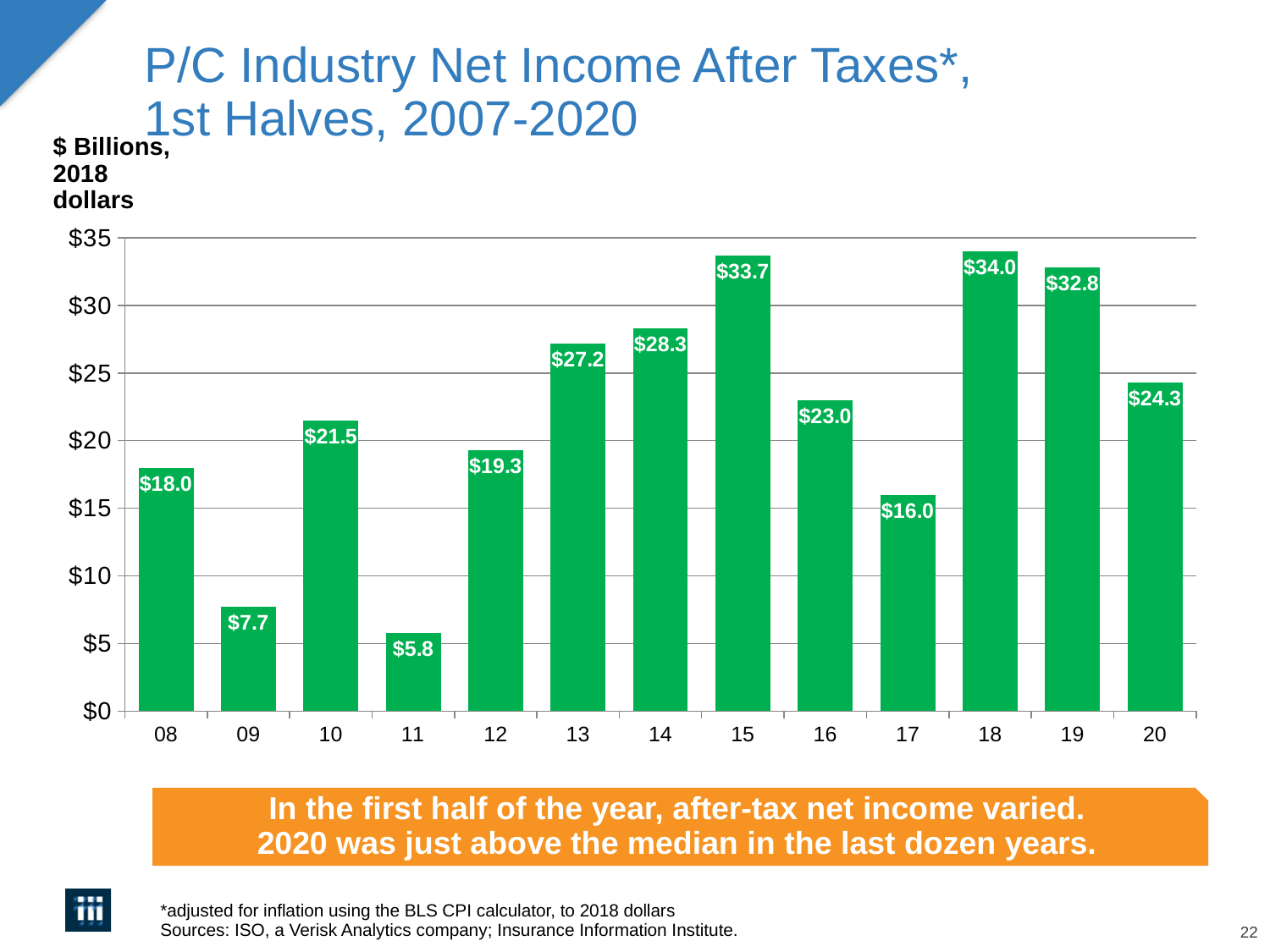
What is the value for 2020 (labelled 20)? $24.3 Which year has the lowest value? 11 What unit is given for the vertical axis of the chart? $ Billions, 2018 dollars What is the difference between the values for 2018 and 2017? $18.0 What is the difference between the values for 2014 and 2013? $1.1 How many bars are plotted in the chart? 13 What is the value for 2015 (labelled 15)? $33.7 Which is larger, the value for 2016 or the value for 2012? 2016 What is the value for 2011 (labelled 11)? $5.8 What is the value for 2009 (labelled 09)? $7.7 Which year has the highest value? 18 What kind of chart is shown on the slide? Bar chart